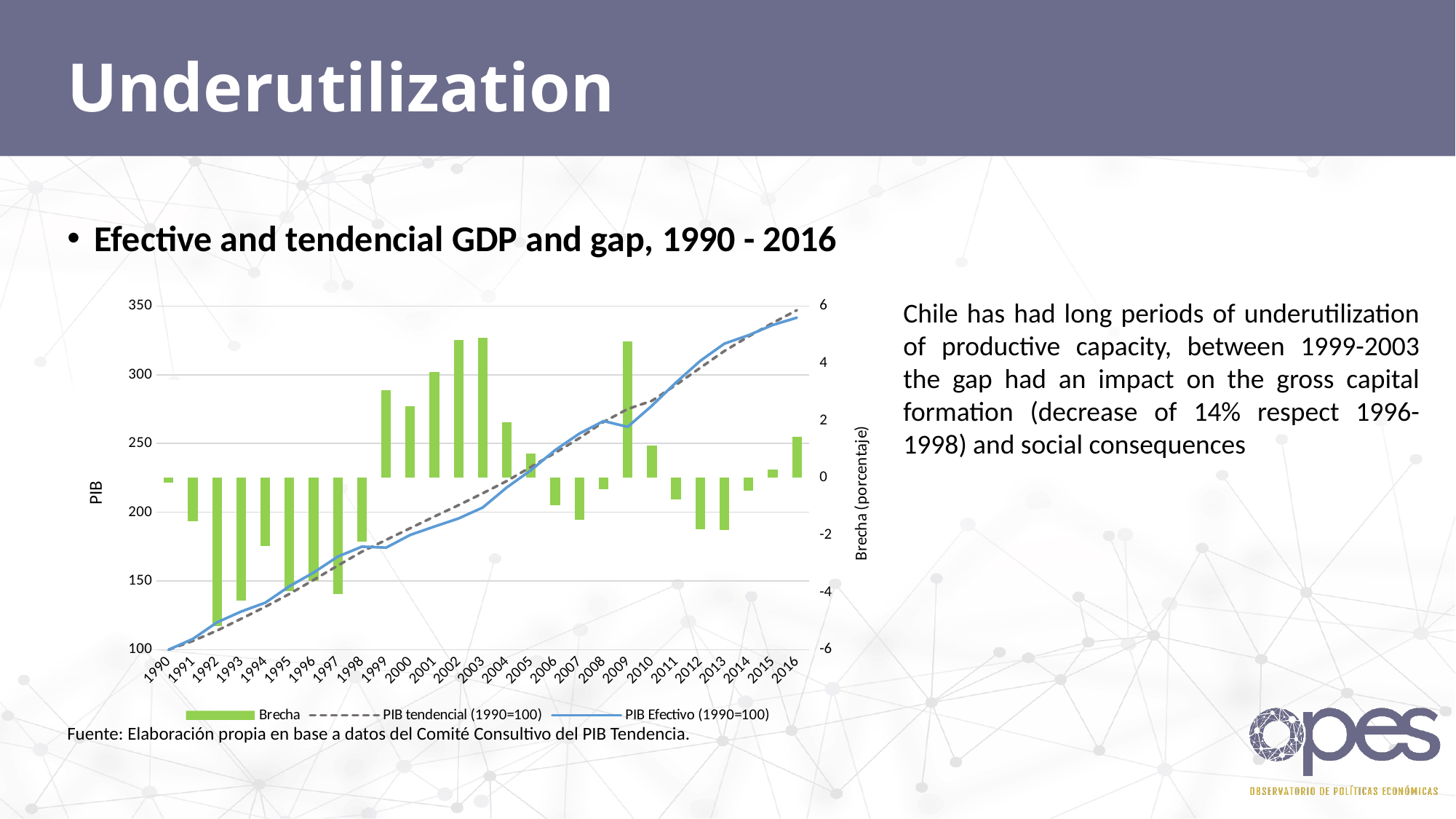
How many years are shown on the x axis of the chart? 27 Is the Brecha value for 1992 greater or less than -4? less Which year has the lowest (most negative) Brecha bar? 1992 How many series does the chart legend list? 3 Which year has the larger Brecha value, 2009 or 2010? 2009 Is the Brecha value for 2003 greater or less than 4? greater What are the three series named in the chart legend? Brecha, PIB tendencial (1990=100), PIB Efectivo (1990=100) What is the value of PIB Efectivo (1990=100) in 1990? 100 What kind of chart is shown on the slide? Combined bar and line chart Does the PIB Efectivo (1990=100) line rise or fall from 1990 to 2016? Rise Is the PIB Efectivo (1990=100) value for 2016 greater or less than 300? greater